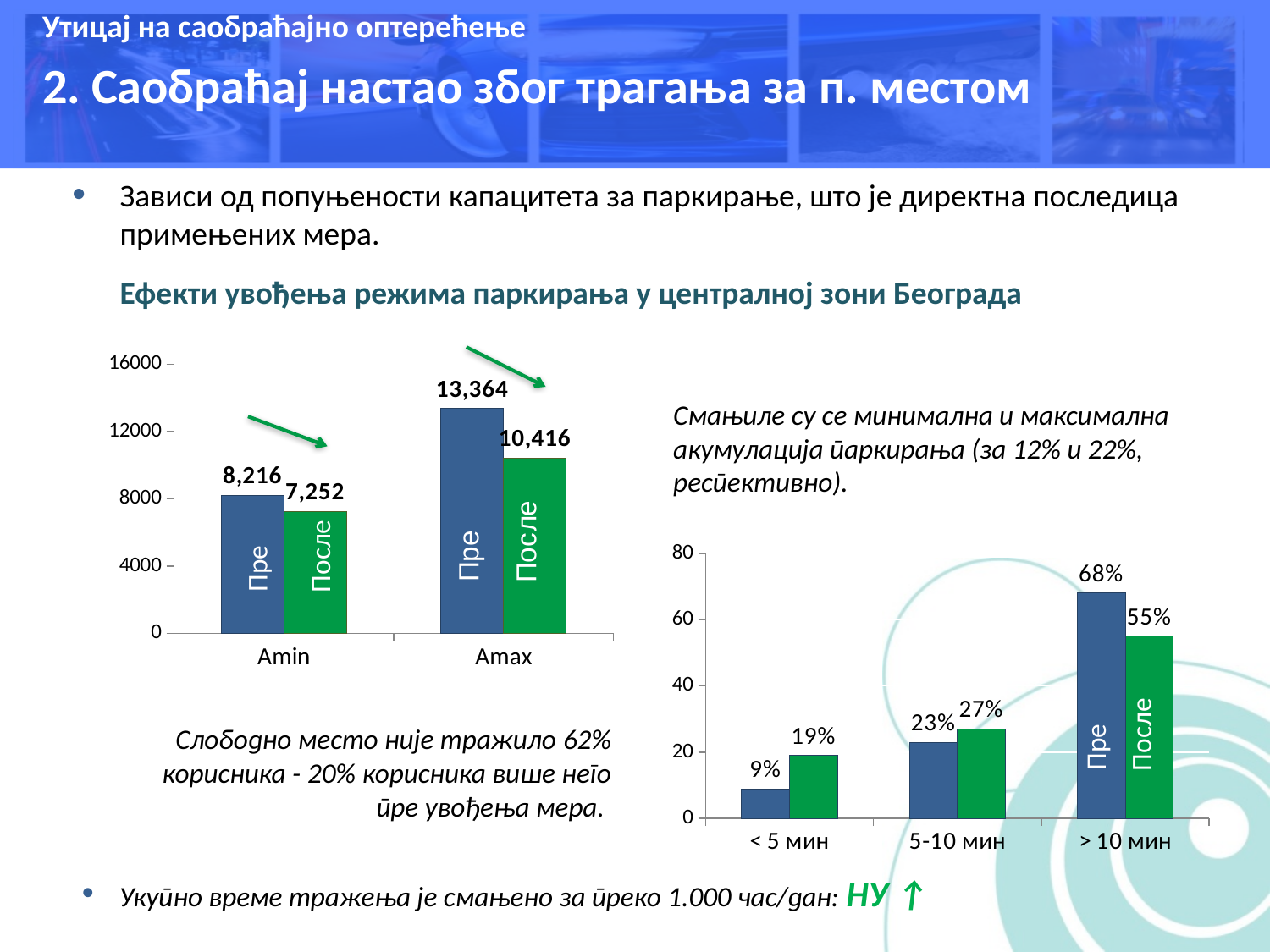
In the left chart, what is the difference between Пре and После at Amax? 2,948 In the right chart, what is the difference between Пре and После in the < 5 мин category? 10% In the left chart, what is the value for Пре at Amax? 13,364 In the right chart, what is the value for После in the > 10 мин category? 55% In the right chart, what is the value for Пре in the < 5 мин category? 9% In the right chart, how many categories are shown on the x axis? 3 In the left chart, what is the value for После at Amin? 7,252 In the left chart, which is larger at Amin: Пре or После? Пре In the left chart, how many categories are shown on the x axis? 2 In the right chart, which is larger in the 5-10 мин category: Пре or После? После In the right chart, which category has the highest value for Пре? > 10 мин What kind of chart is the left chart? bar chart